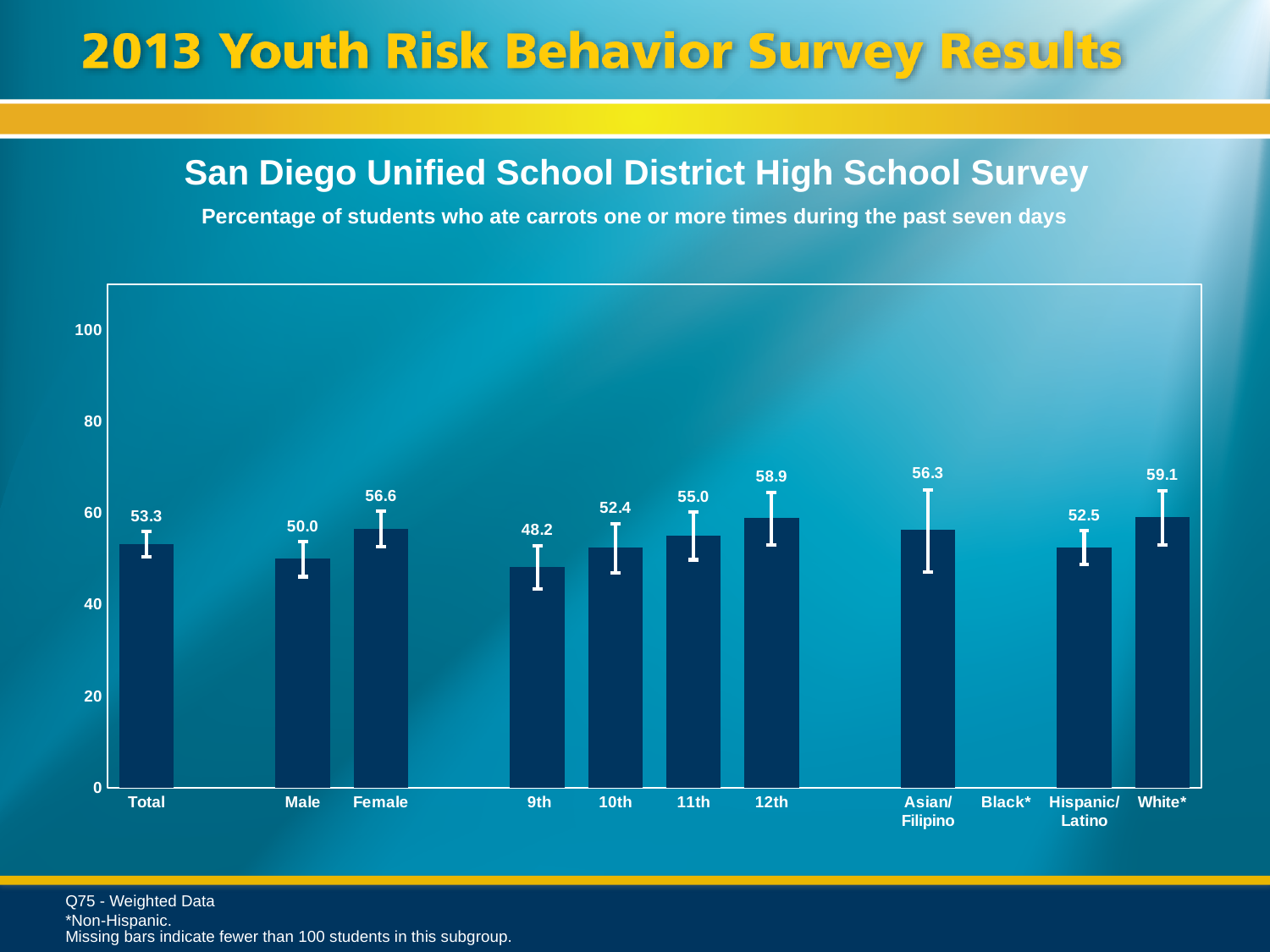
What is the value shown for Female students? 56.6 What is the difference between the Female and Male values? 6.6 What is the value shown for 9th grade students? 48.2 What is the value shown for Asian/Filipino students? 56.3 Is the value for 11th grade greater or less than 60? less Among the grade levels (9th, 10th, 11th, 12th), which has the highest percentage? 12th Which category label has no bar plotted? Black* What kind of chart is shown on the slide? bar chart What percentage of students in the Total category ate carrots one or more times during the past seven days? 53.3 Which is larger, the value for Hispanic/Latino or the value for White*? White* Which category has the lowest percentage on the chart? 9th How many bars are plotted on the chart? 10